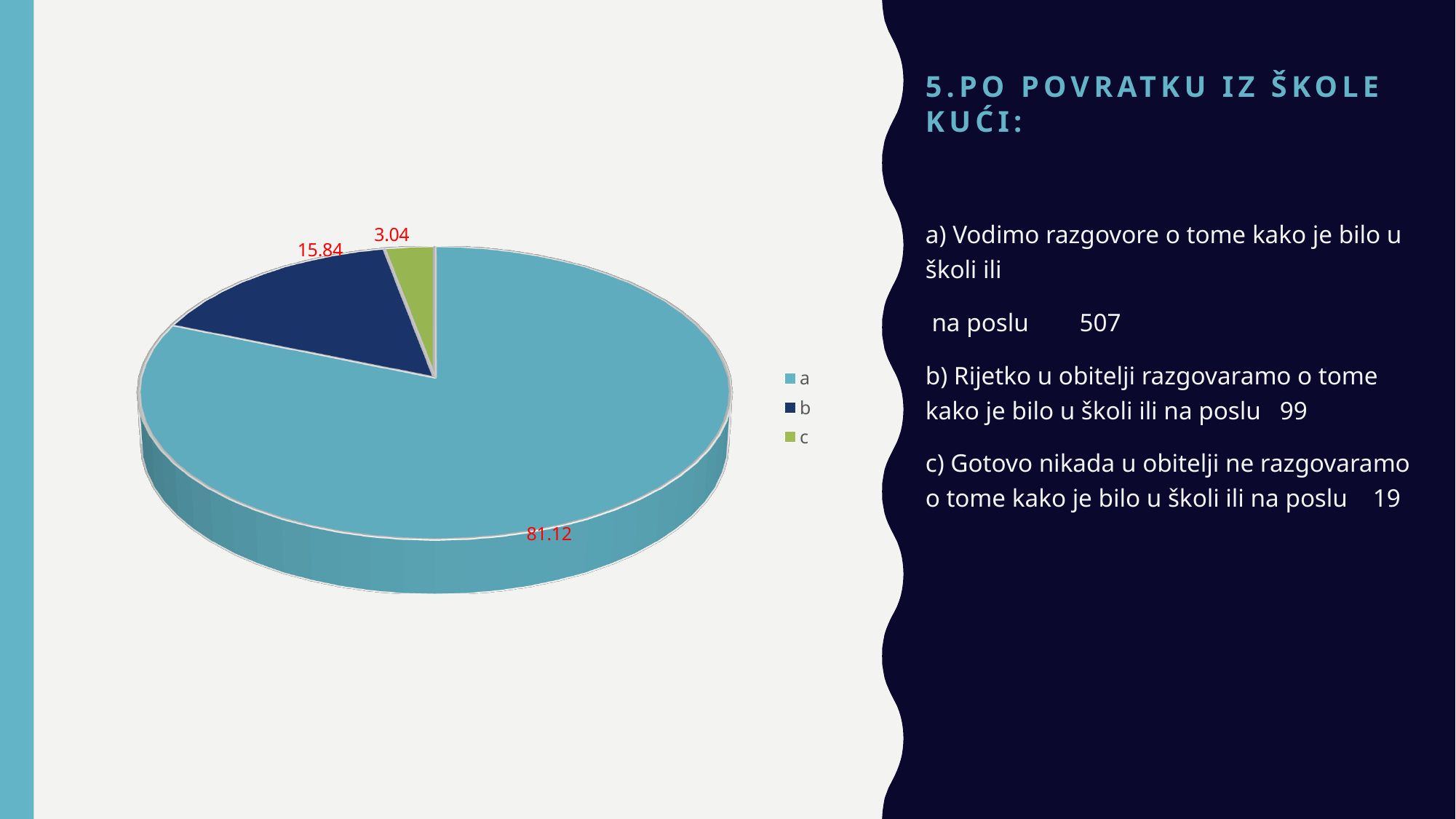
Which slice is the smallest? c What kind of chart is shown on the slide? pie chart How many slices does the pie chart have? 3 What colour is slice c in the pie chart? green Which is larger, the value for b or the value for c? b What is the difference between the values for b and c? 12.80 How many entries does the legend list? 3 Which slice is the largest? a What is the value shown for slice b? 15.84 What is the value shown for slice a? 81.12 What is the difference between the values for a and b? 65.28 What is the value shown for slice c? 3.04